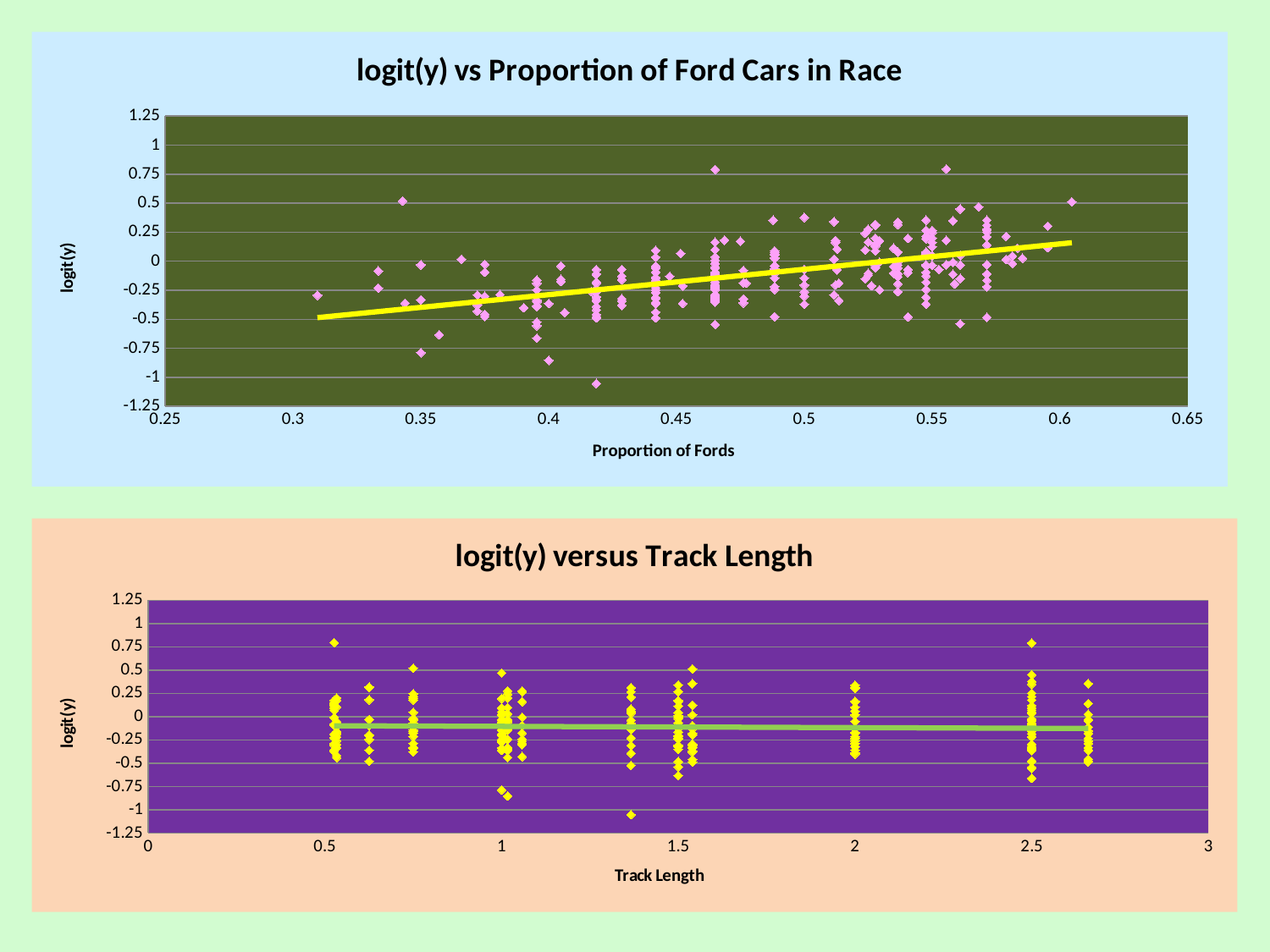
What kind of chart is the top chart, 'logit(y) vs Proportion of Ford Cars in Race'? scatter chart In the bottom chart, 'logit(y) versus Track Length', what is the lowest value shown on the y-axis? -1.25 What is the x-axis label of the bottom chart? Track Length In the top chart, 'logit(y) vs Proportion of Ford Cars in Race', what is the highest value shown on the y-axis? 1.25 In the top chart, 'logit(y) vs Proportion of Ford Cars in Race', is the trend line's value at a proportion of 0.35 greater or less than 0? less In the top chart, 'logit(y) vs Proportion of Ford Cars in Race', does the fitted trend line rise or fall as the proportion of Fords increases? rise In the bottom chart, 'logit(y) versus Track Length', does the fitted trend line rise noticeably, fall noticeably, or stay roughly flat as track length increases? roughly flat What kind of chart is the bottom chart, 'logit(y) versus Track Length'? scatter chart In the top chart, 'logit(y) vs Proportion of Ford Cars in Race', what is the largest value shown on the x-axis? 0.65 What is the title of the top chart? logit(y) vs Proportion of Ford Cars in Race In the top chart, 'logit(y) vs Proportion of Ford Cars in Race', is the trend line's value at a proportion of 0.6 greater or less than 0? greater In the bottom chart, 'logit(y) versus Track Length', what is the largest value shown on the x-axis? 3